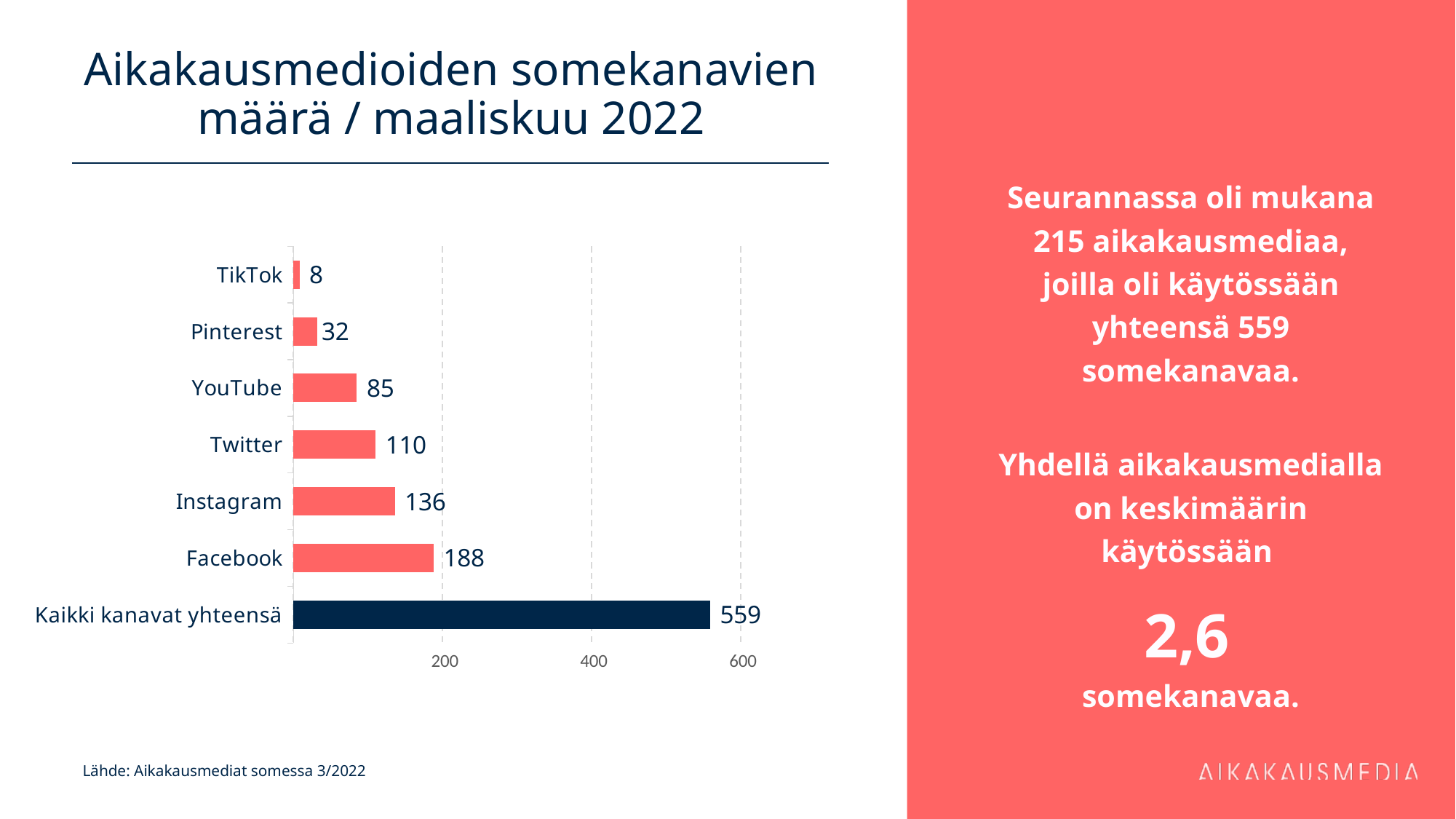
How many categories (bars) are shown in the chart? 7 What is the value for Instagram? 136 What kind of chart is shown on the slide? Bar chart Which individual channel (excluding the total bar) has the highest value? Facebook What is the value for TikTok? 8 What is the difference between the values for Twitter and YouTube? 25 Which category has the lowest value? TikTok What is the difference between the values for Facebook and Instagram? 52 What is the title of the chart on the slide? Aikakausmedioiden somekanavien määrä / maaliskuu 2022 What is the value for Facebook? 188 Which is larger, the value for Pinterest or the value for YouTube? YouTube What is the value for Kaikki kanavat yhteensä? 559